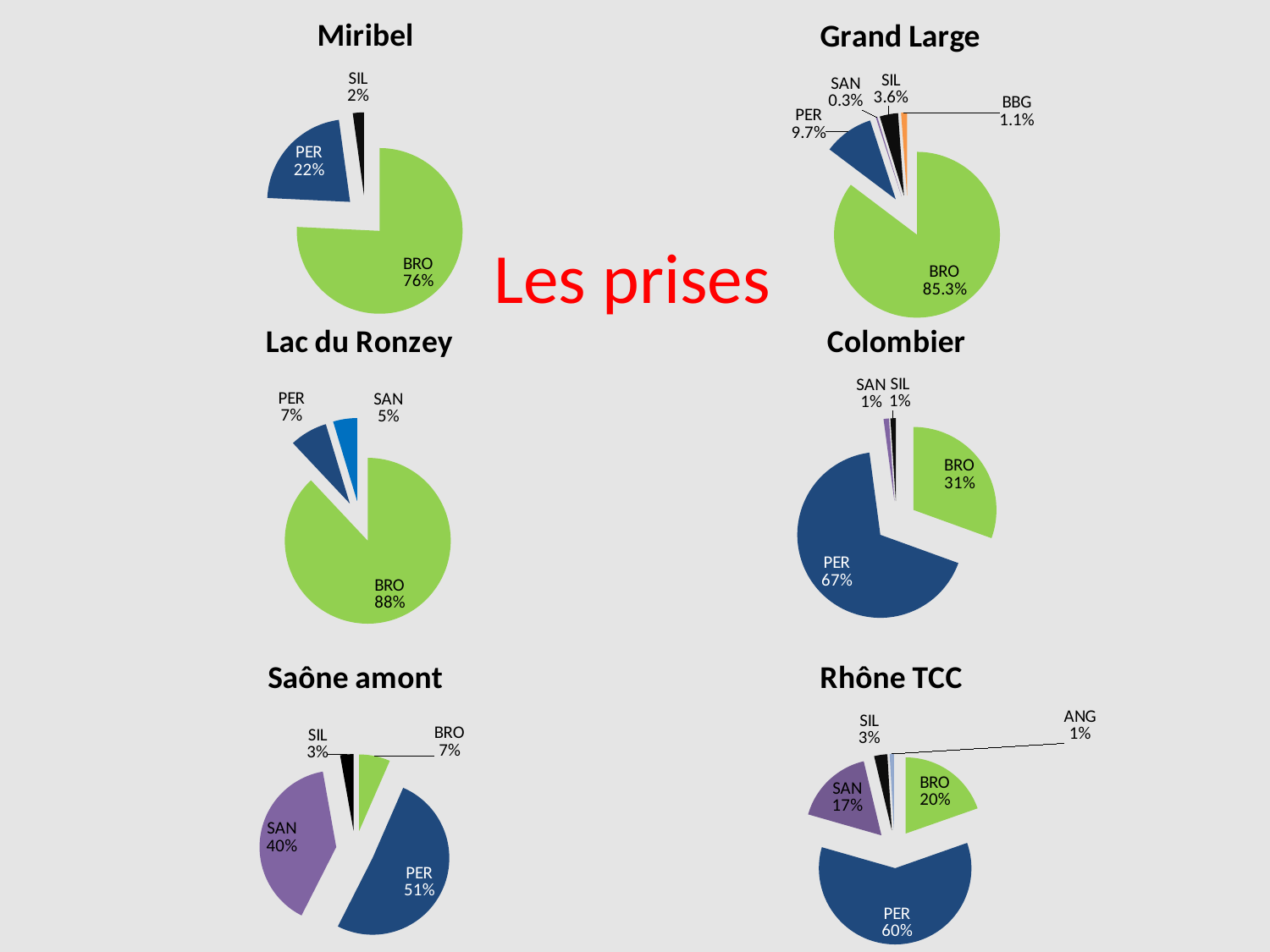
In the Rhône TCC chart, what is the value for SAN? 17% In the Colombier chart, which category has the largest share? PER In the Miribel chart, what share does BRO have? 76% In the Saône amont chart, which is larger, SAN or PER? PER How many pie charts are shown on the slide? 6 How many slices does the Grand Large pie chart have? 5 In the Grand Large chart, which category has the smallest share? SAN What kind of chart is the Rhône TCC chart? pie chart In the Saône amont chart, what is the value for SIL? 3% In the Lac du Ronzey chart, what is the value for SAN? 5% In the Grand Large chart, what is the value for PER? 9.7% In the Colombier chart, what is the difference between PER and BRO? 36%